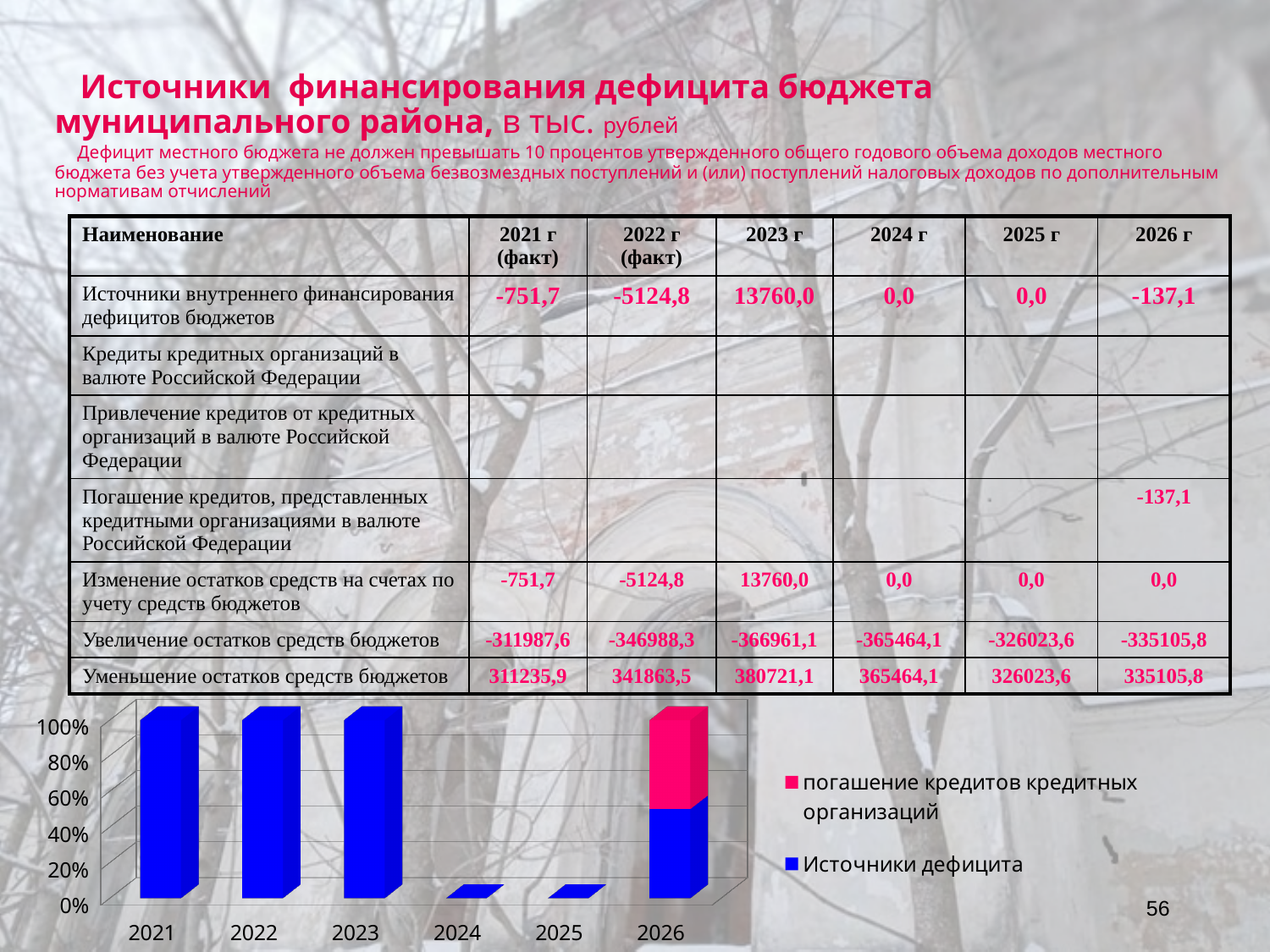
Which series in the bar chart is shown in pink? погашение кредитов кредитных организаций In the bar chart, is the value for Источники дефицита in 2024 greater or less than 20%? less How many years are shown on the x axis of the bar chart? 6 In the bar chart, which year is the only one with a visible pink segment for погашение кредитов кредитных организаций? 2026 In the bar chart, which bar is taller for Источники дефицита: 2023 or 2025? 2023 Which series in the bar chart is shown in blue? Источники дефицита In the bar chart, is the value for Источники дефицита in 2026 greater or less than 80%? less What kind of chart is shown at the bottom of the slide? bar chart In the bar chart, is the value for погашение кредитов кредитных организаций in 2026 greater or less than 20%? greater How many series does the legend of the bar chart list? 2 In the bar chart, which year has the lowest value for Источники дефицита: 2022 or 2024? 2024